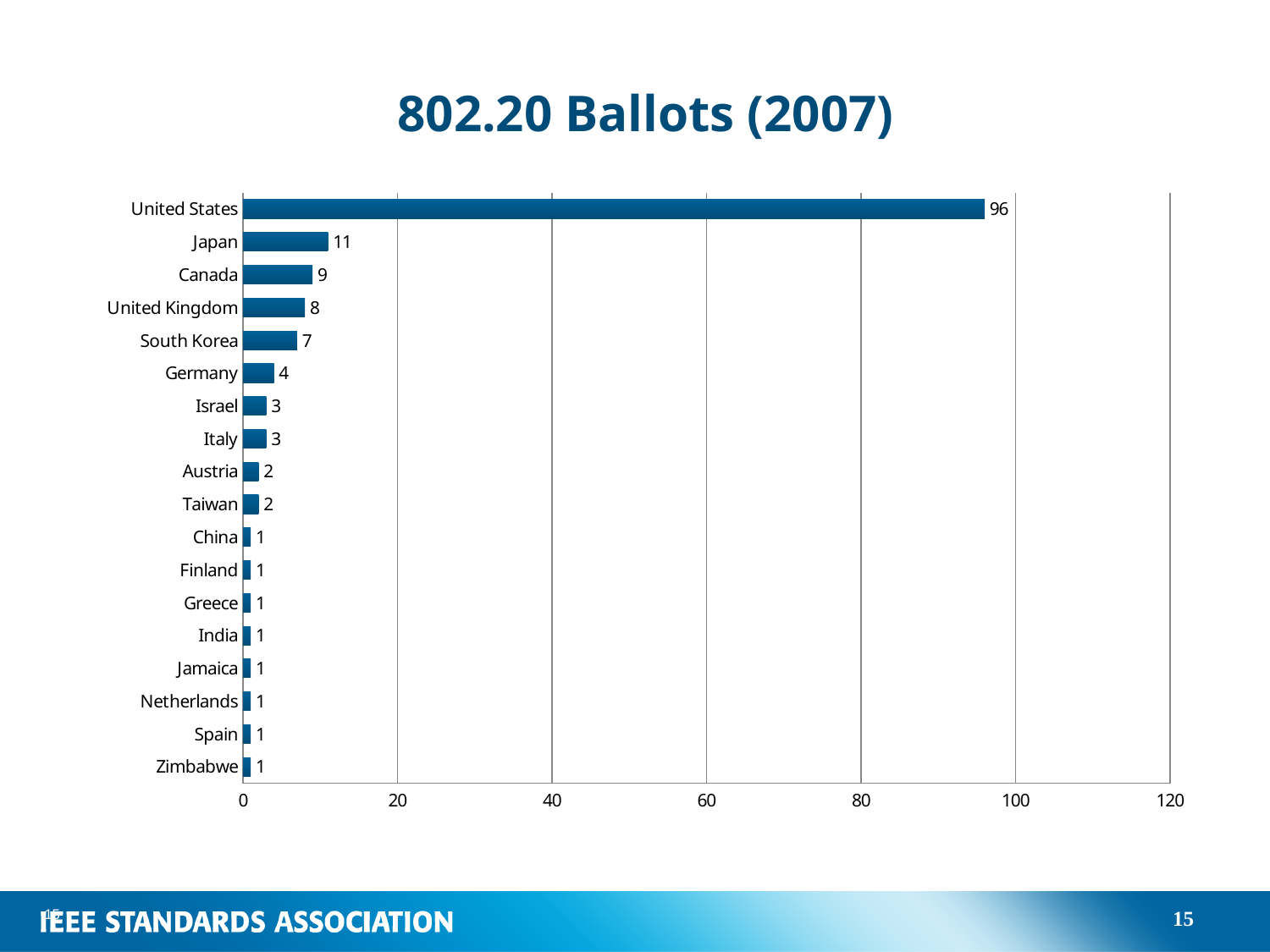
What is the difference between the values for the United States and Japan? 85 Which is larger, the value for Germany or the value for Israel? Germany Is the value for the United States greater or less than 80? greater What is the value for South Korea? 7 What kind of chart is shown on the slide? bar chart How many countries have a value of 1? 8 How many ballots does the United States have? 96 What is the difference between the values for Canada and the United Kingdom? 1 What is the value for Japan? 11 What is the title of the chart? 802.20 Ballots (2007) How many countries are shown on the chart? 18 Which country has the highest number of ballots? United States